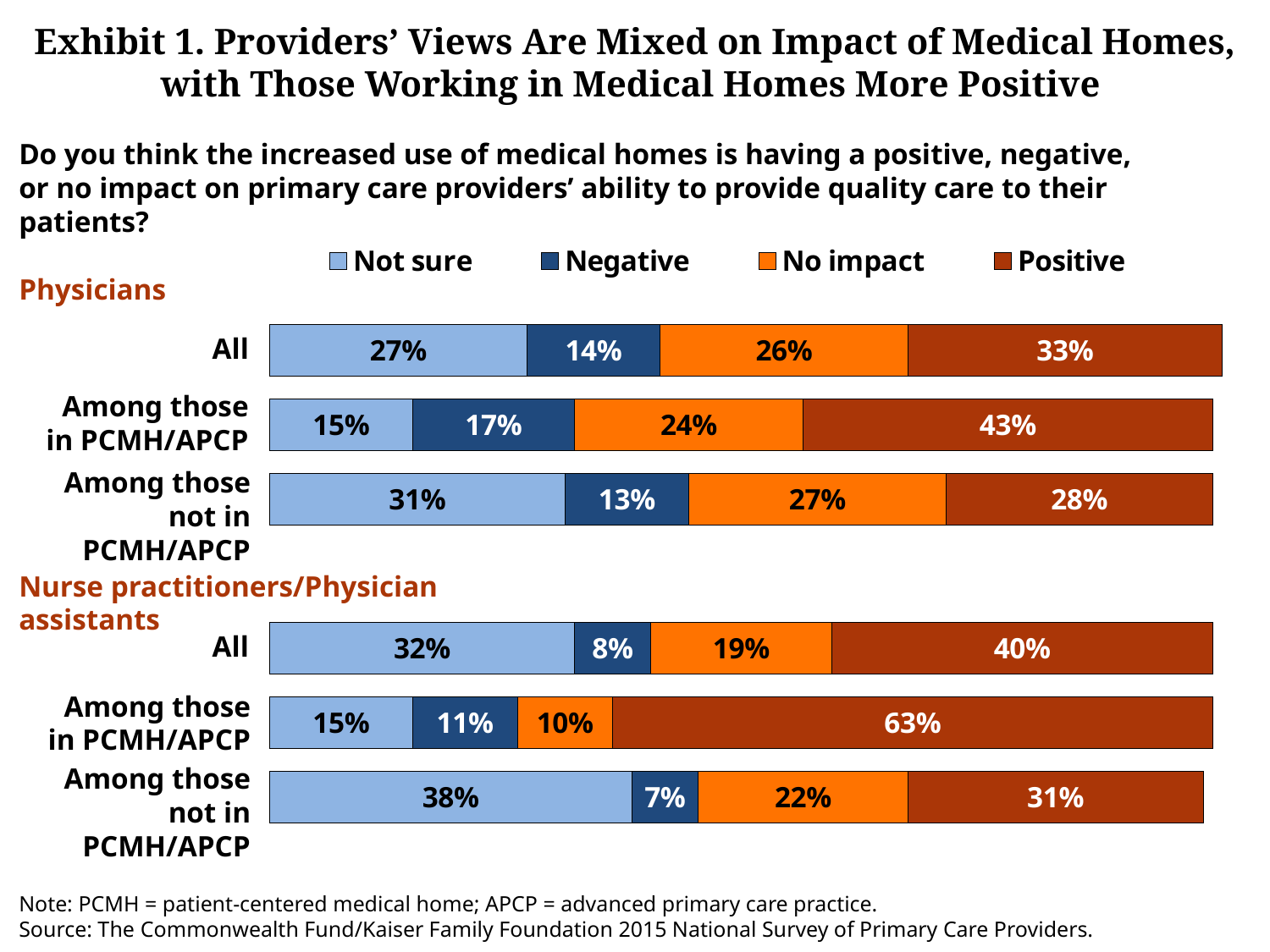
In the Physicians chart, what is the total of the 'Not sure' and 'Negative' segments for all physicians? 41% In the Nurse practitioners/Physician assistants chart, which group has the lowest 'Not sure' percentage? Among those in PCMH/APCP In the Physicians chart, which group has the highest 'Positive' percentage? Among those in PCMH/APCP What type of chart is used on this slide? Stacked bar chart In the Nurse practitioners/Physician assistants chart, which is larger: the 'No impact' percentage for all respondents or for those not in PCMH/APCP? Among those not in PCMH/APCP In the Physicians chart, what is the difference between the 'Positive' percentage for those in PCMH/APCP and those not in PCMH/APCP? 15 percentage points In the Nurse practitioners/Physician assistants chart, what percentage of those not in PCMH/APCP answered 'Negative'? 7% In the Physicians chart, what percentage of those not in PCMH/APCP answered 'Not sure'? 31% In the Physicians chart, what percentage of all physicians said medical homes have a positive impact? 33% In the Nurse practitioners/Physician assistants chart, what percentage of those in PCMH/APCP said medical homes have a positive impact? 63% How many response categories does the legend list? 4 Which colour represents the 'Positive' response in the legend? Dark red